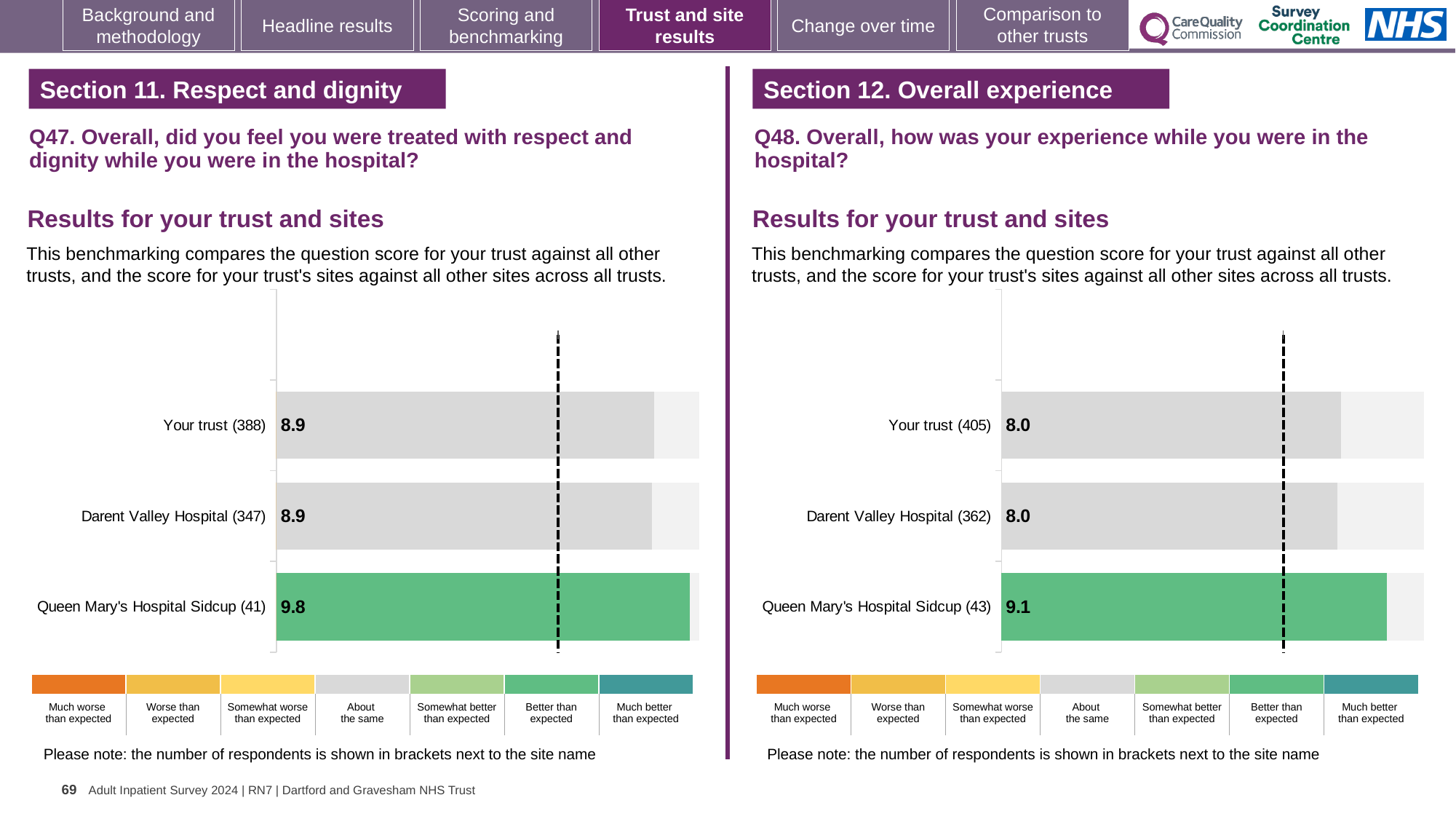
In the Q48 chart on the right, what is the score for Queen Mary's Hospital Sidcup? 9.1 Is the score for Queen Mary's Hospital Sidcup higher in the Q47 chart on the left or in the Q48 chart on the right? Q47 chart on the left In the Q47 chart on the left, what is the score for Queen Mary's Hospital Sidcup? 9.8 How many bars are shown in the Q48 chart on the right? 3 In the Q47 chart on the left, which site or trust has the highest score? Queen Mary's Hospital Sidcup In the Q47 chart on the left, what is the score for Your trust? 8.9 In the Q47 chart on the left, what is the difference between the scores for Queen Mary's Hospital Sidcup and Darent Valley Hospital? 0.9 What type of chart is used in the Q47 chart on the left? Bar chart In the Q48 chart on the right, how many respondents are shown in brackets for Your trust? 405 In the Q48 chart on the right, what is the score for Darent Valley Hospital? 8.0 In the Q48 chart on the right, which site or trust has the highest score? Queen Mary's Hospital Sidcup In the Q48 chart on the right, what is the difference between the scores for Queen Mary's Hospital Sidcup and Your trust? 1.1